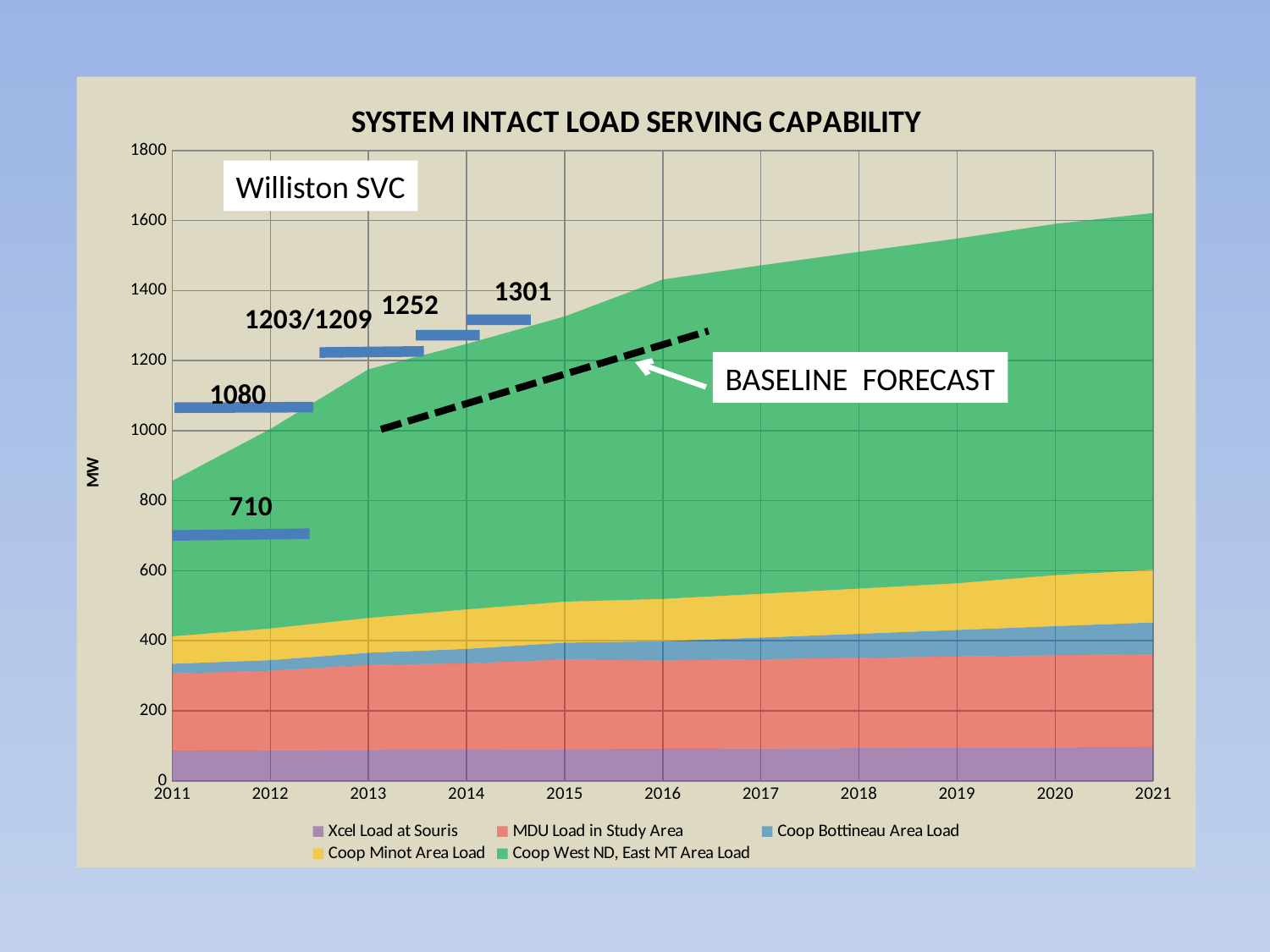
How many years are labelled along the x axis? 11 Which series is shown in green in the legend? Coop West ND, East MT Area Load What is the difference between the labelled capability values 1301 and 1252? 49 What kind of chart is shown on the slide? stacked area chart Does the total stacked load rise or fall from 2011 to 2021? rise What is the highest labelled load serving capability value shown on the chart? 1301 Is the total stacked load in 2016 greater or less than 1200? greater What is the lowest labelled load serving capability value shown on the chart? 710 What is the title of the chart? SYSTEM INTACT LOAD SERVING CAPABILITY How many series does the legend list? 5 Is the value for Xcel Load at Souris in 2021 greater or less than 200? less Is the total stacked load in 2011 greater or less than 1000? less